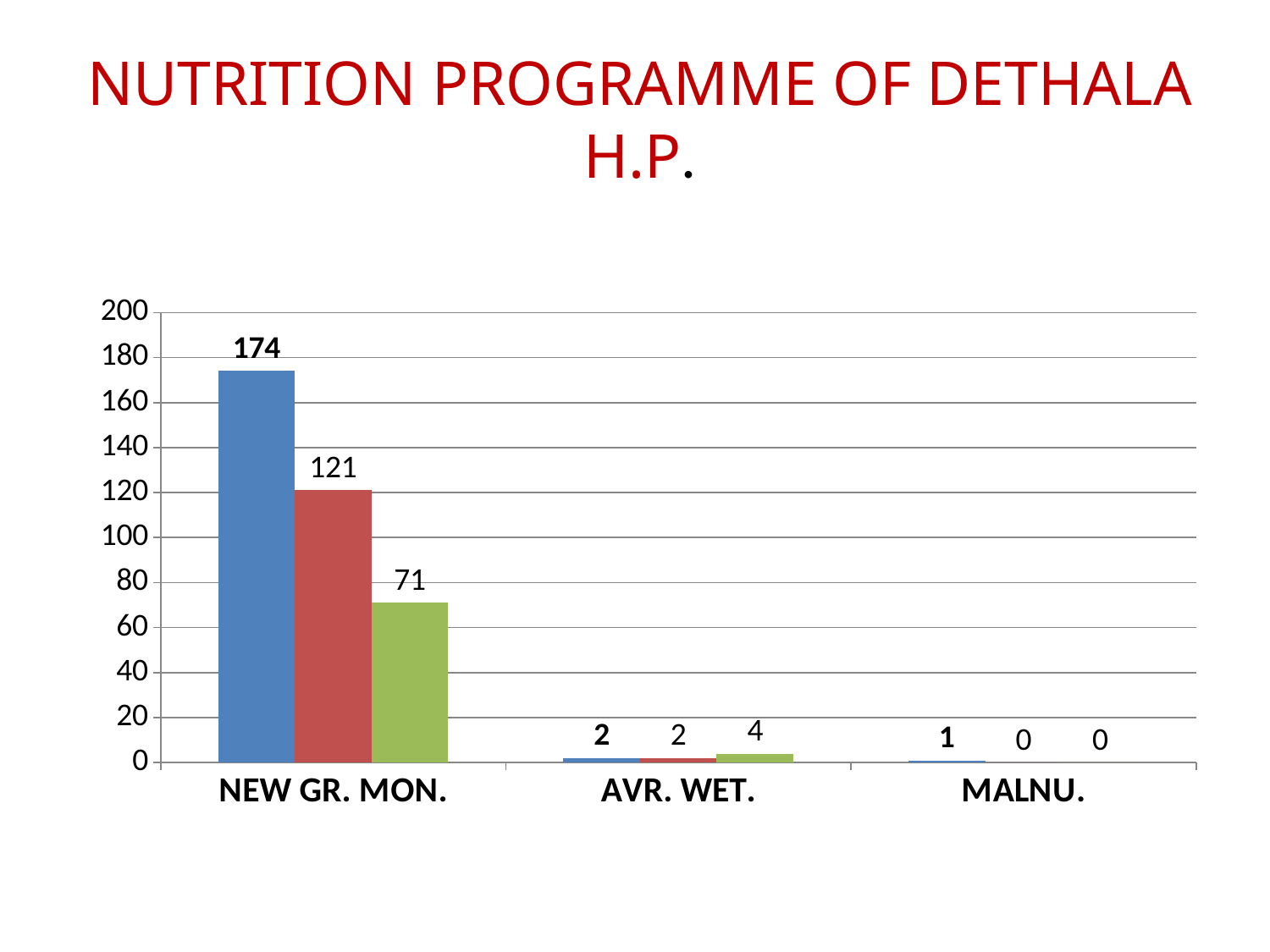
Which category has the highest blue bar? NEW GR. MON. What kind of chart is shown on the slide? bar chart Which is larger for NEW GR. MON., the red bar or the green bar? the red bar What is the value of the red bar for NEW GR. MON.? 121 What is the value of the blue bar for MALNU.? 1 What is the title of the slide? NUTRITION PROGRAMME OF DETHALA H.P. Which category has the lowest green bar? MALNU. What is the difference between the blue and red bars for NEW GR. MON.? 53 What is the value of the blue bar for NEW GR. MON.? 174 How many categories are shown on the x axis? 3 What is the value of the green bar for NEW GR. MON.? 71 What is the value of the green bar for AVR. WET.? 4